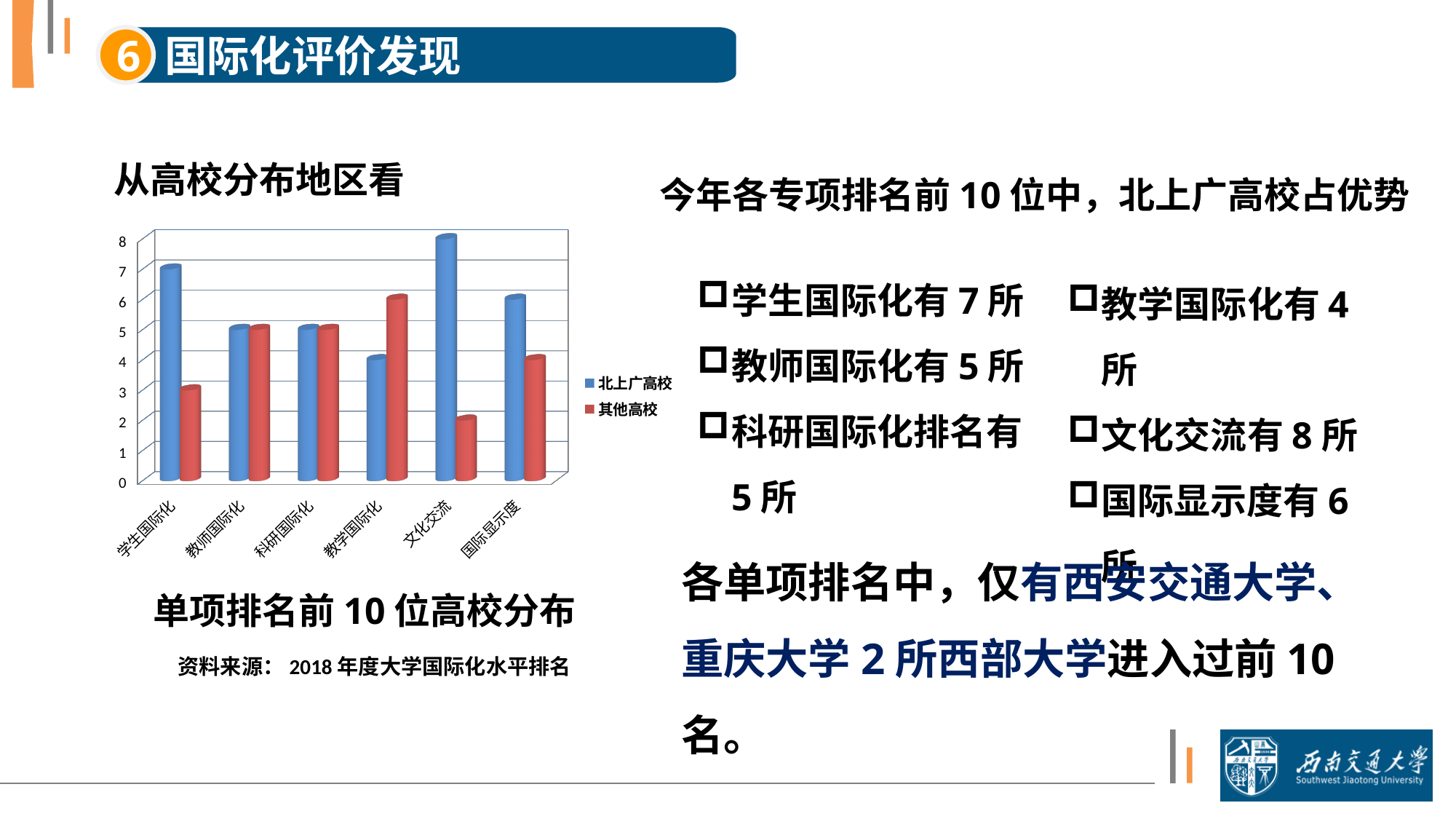
How many series does the chart legend list? 2 How many categories are shown on the x axis of the chart? 6 What is the value for 北上广高校 in the 国际显示度 category? 6 Which series is shown in blue in the chart? 北上广高校 Which category has the highest value for 北上广高校? 文化交流 What is the value for 北上广高校 in the 学生国际化 category? 7 Which category has the lowest value for 北上广高校? 教学国际化 What is the value for 北上广高校 in the 教学国际化 category? 4 What kind of chart is shown on the slide? bar chart Is the value for 其他高校 in the 文化交流 category greater or less than 4? less What is the value for 北上广高校 in the 文化交流 category? 8 In the 教学国际化 category, which series has the larger value, 北上广高校 or 其他高校? 其他高校